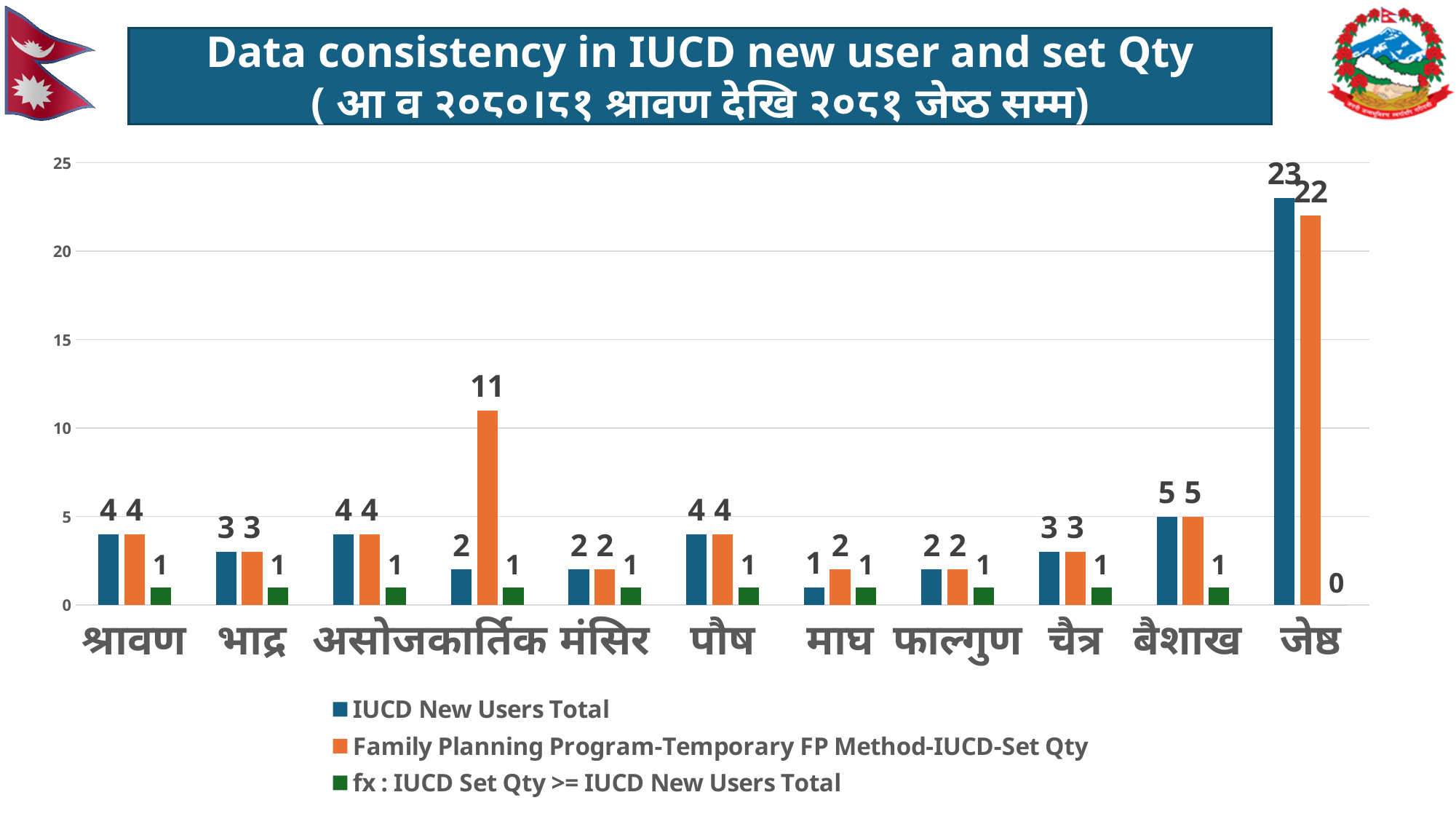
What kind of chart is shown on the slide? bar chart Which month has the highest IUCD New Users Total? जेष्ठ What is the fx : IUCD Set Qty >= IUCD New Users Total value for जेष्ठ? 0 What is the Family Planning Program-Temporary FP Method-IUCD-Set Qty value for कार्तिक? 11 What is the difference between the IUCD Set Qty and the IUCD New Users Total for कार्तिक? 9 Which month has the lowest IUCD New Users Total? माघ What colour are the bars for IUCD New Users Total? blue How many months are shown on the x axis? 11 How many series does the legend list? 3 For जेष्ठ, which is larger: IUCD New Users Total or IUCD Set Qty? IUCD New Users Total Is the IUCD Set Qty value for जेष्ठ greater or less than 20? greater What is the IUCD New Users Total for जेष्ठ? 23